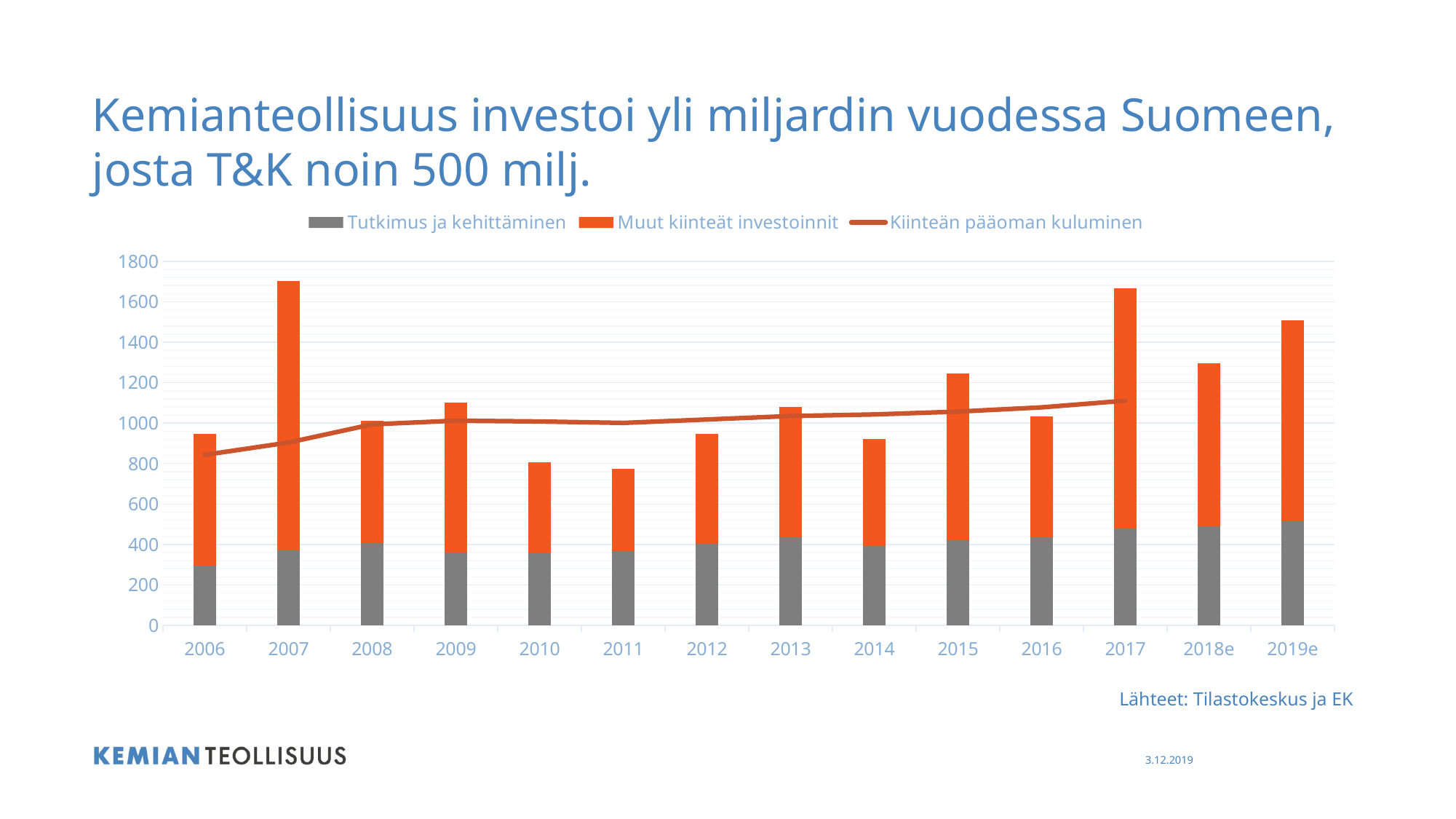
Which has the taller stacked bar, 2018e or 2019e? 2019e Which has the taller stacked bar, 2010 or 2015? 2015 How many years are shown on the x axis of the chart? 14 Which legend entry is shown in grey? Tutkimus ja kehittäminen Which year has the tallest stacked bar in the chart? 2007 Is the total stacked bar for 2011 greater or less than 1000? less How many series does the chart legend list? 3 What kind of chart is shown on the slide? combination bar and line chart Does the Kiinteän pääoman kuluminen line rise or fall from 2006 to 2017? rise Is the total stacked bar for 2019e greater or less than 1400? greater Is the total stacked bar for 2007 greater or less than 1600? greater